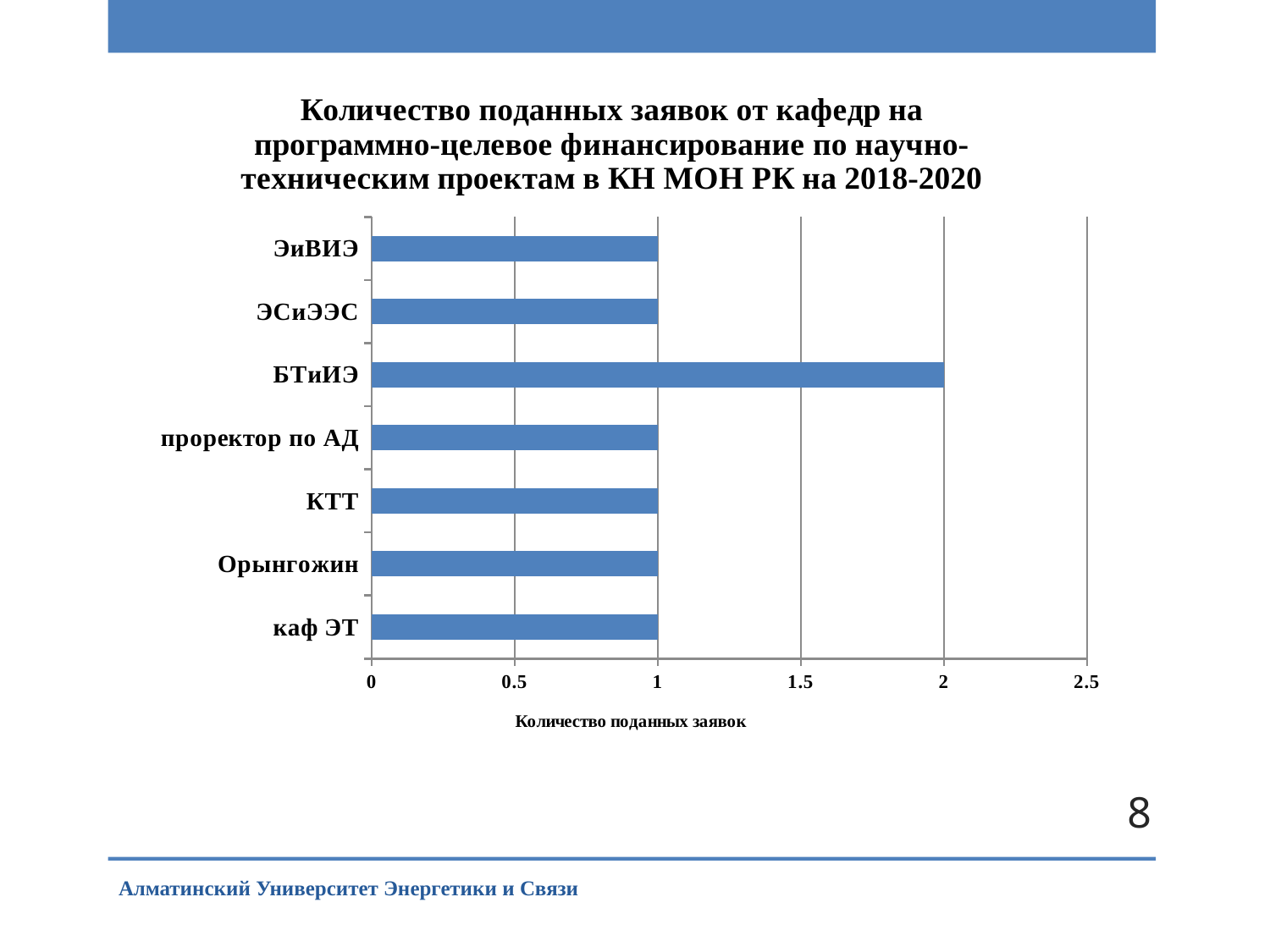
What is the difference between the values for БТиИЭ and Орынгожин? 1 What is the value for БТиИЭ? 2 What kind of chart is shown on the slide? bar chart What is the value for КТТ? 1 Which category has the highest number of submitted applications? БТиИЭ How many categories are plotted in the chart? 7 Is the value for ЭСиЭЭС greater or less than 1.5? less What is the value for ЭиВИЭ? 1 What is the label of the horizontal axis? Количество поданных заявок Which is larger, the value for БТиИЭ or the value for проректор по АД? БТиИЭ What is the value for каф ЭТ? 1 What is the highest tick value shown on the horizontal axis? 2.5